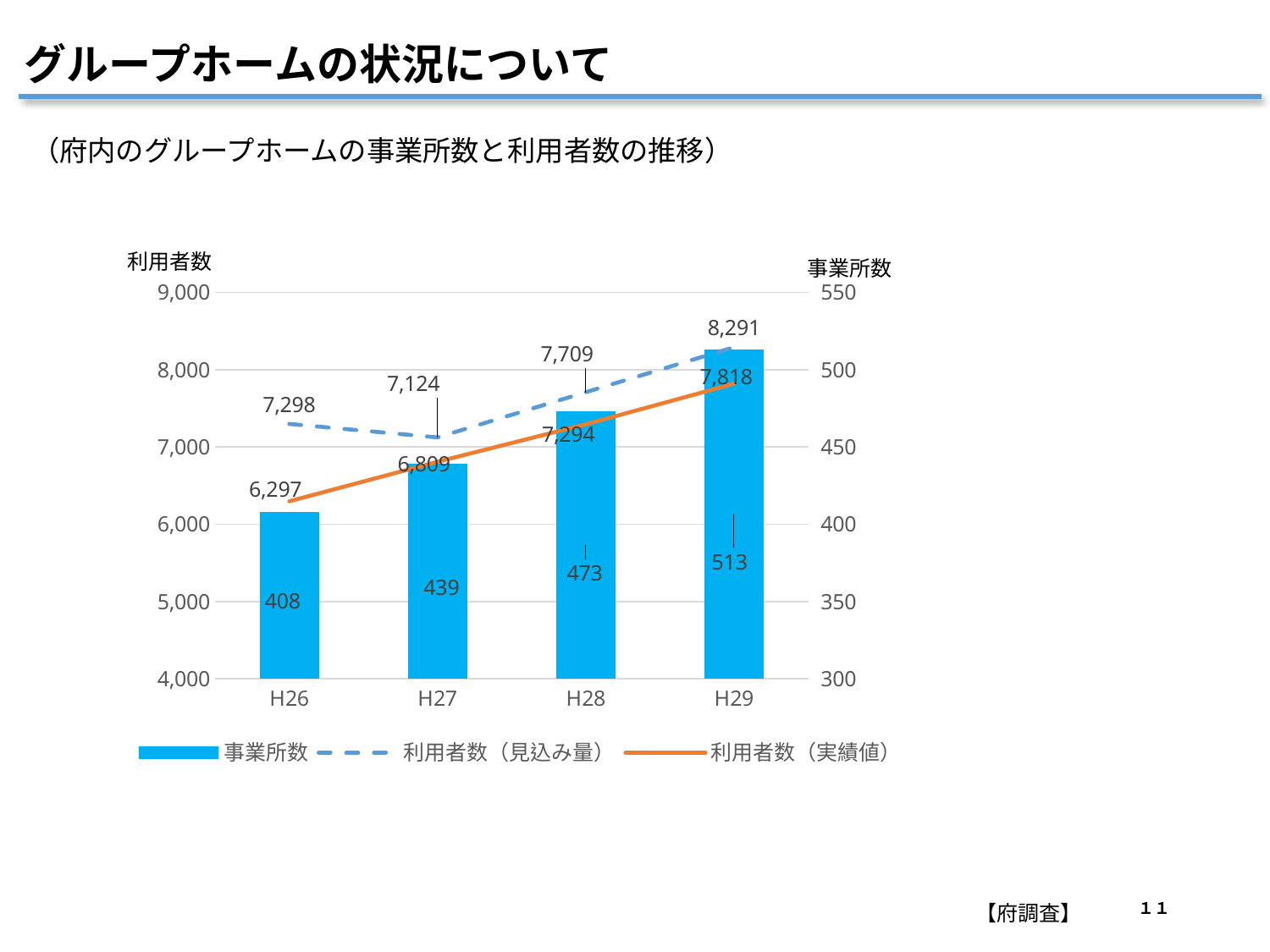
Does 利用者数（実績値） rise or fall from H26 to H29? rise Which year has the highest 事業所数? H29 Which series is drawn as a dashed line? 利用者数（見込み量） What is the value of 利用者数（実績値） for H29? 7,818 What is the value of 事業所数 for H26? 408 What is the value of 利用者数（見込み量） for H27? 7,124 Which year has the lowest 利用者数（見込み量）? H27 How many years are shown on the x axis? 4 Which is larger in H26, 利用者数（見込み量） or 利用者数（実績値）? 利用者数（見込み量） What is the difference between 事業所数 in H29 and H26? 105 What is the difference between 利用者数（見込み量） and 利用者数（実績値） in H28? 415 How many series does the legend list? 3